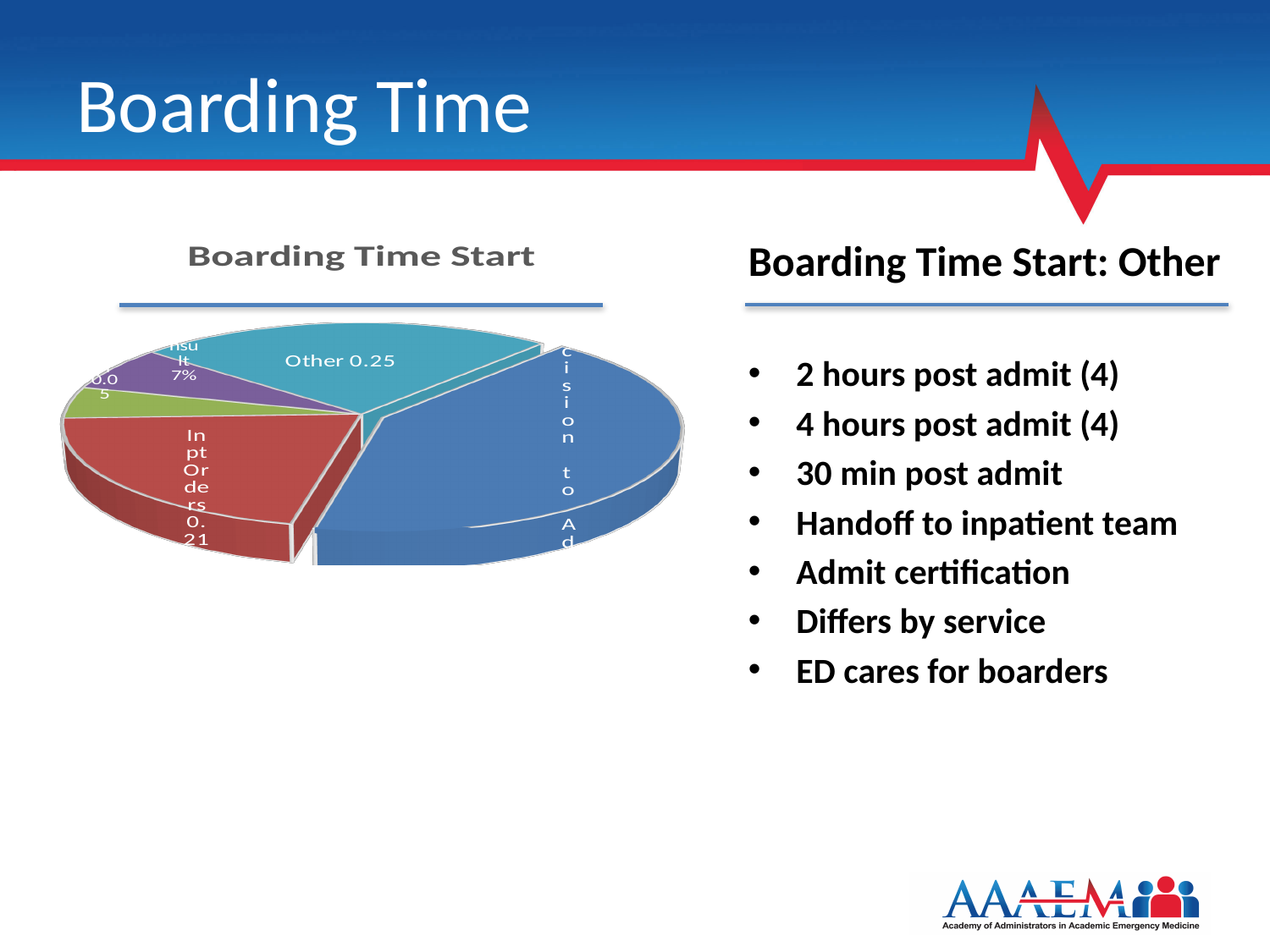
Which slice is larger in the Boarding Time Start pie chart, Other or Inpt Orders? Other What value is printed on the smallest slice of the Boarding Time Start pie chart? 0.05 Which slice is the largest in the Boarding Time Start pie chart? Decision to Admit What value is shown for the Inpt Orders slice in the Boarding Time Start pie chart? 0.21 What colour is the Other slice in the Boarding Time Start pie chart? Teal What kind of chart is shown on the slide? Pie chart What is the difference between the Other value and the Inpt Orders value in the Boarding Time Start pie chart? 0.04 What value is shown for the Other slice in the Boarding Time Start pie chart? 0.25 What is the title of the chart? Boarding Time Start How many slices does the Boarding Time Start pie chart have? 5